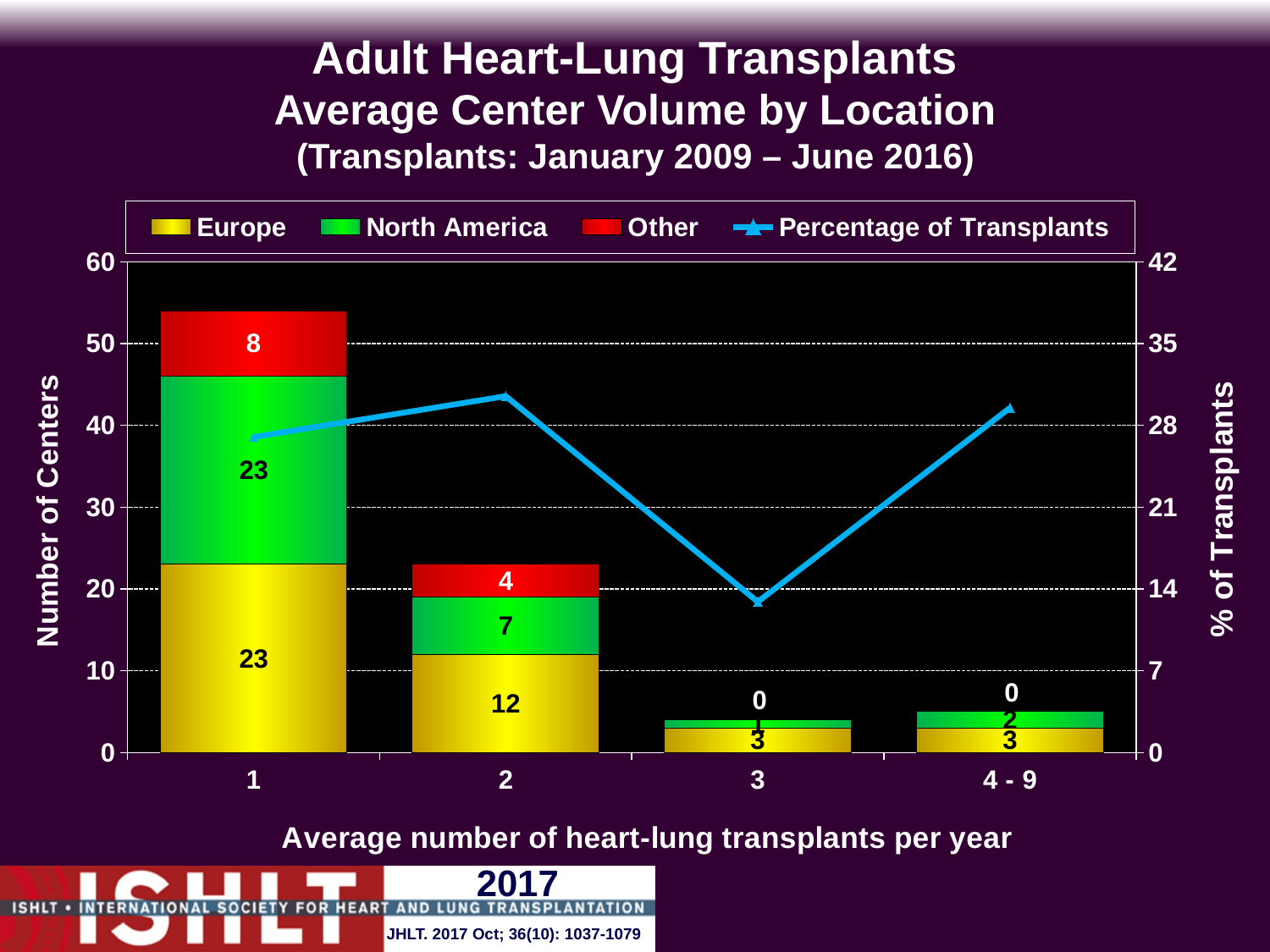
What is the North America value for the category 2 bar? 7 Is the Percentage of Transplants value for category 2 greater or less than 28? greater Which category has the highest total number of centers? 1 What is the difference between the Europe values for categories 1 and 2? 11 What is the Other value for the category 1 bar? 8 How many series does the legend list? 4 What is the total number of centers for the category 2 stacked bar? 23 What is the total number of centers for the category 1 stacked bar? 54 Is the Percentage of Transplants value for category 3 greater or less than 21? less What is the Europe value for the 4 - 9 category? 3 What is the Europe value for the category 1 bar? 23 How many categories are shown on the x axis? 4